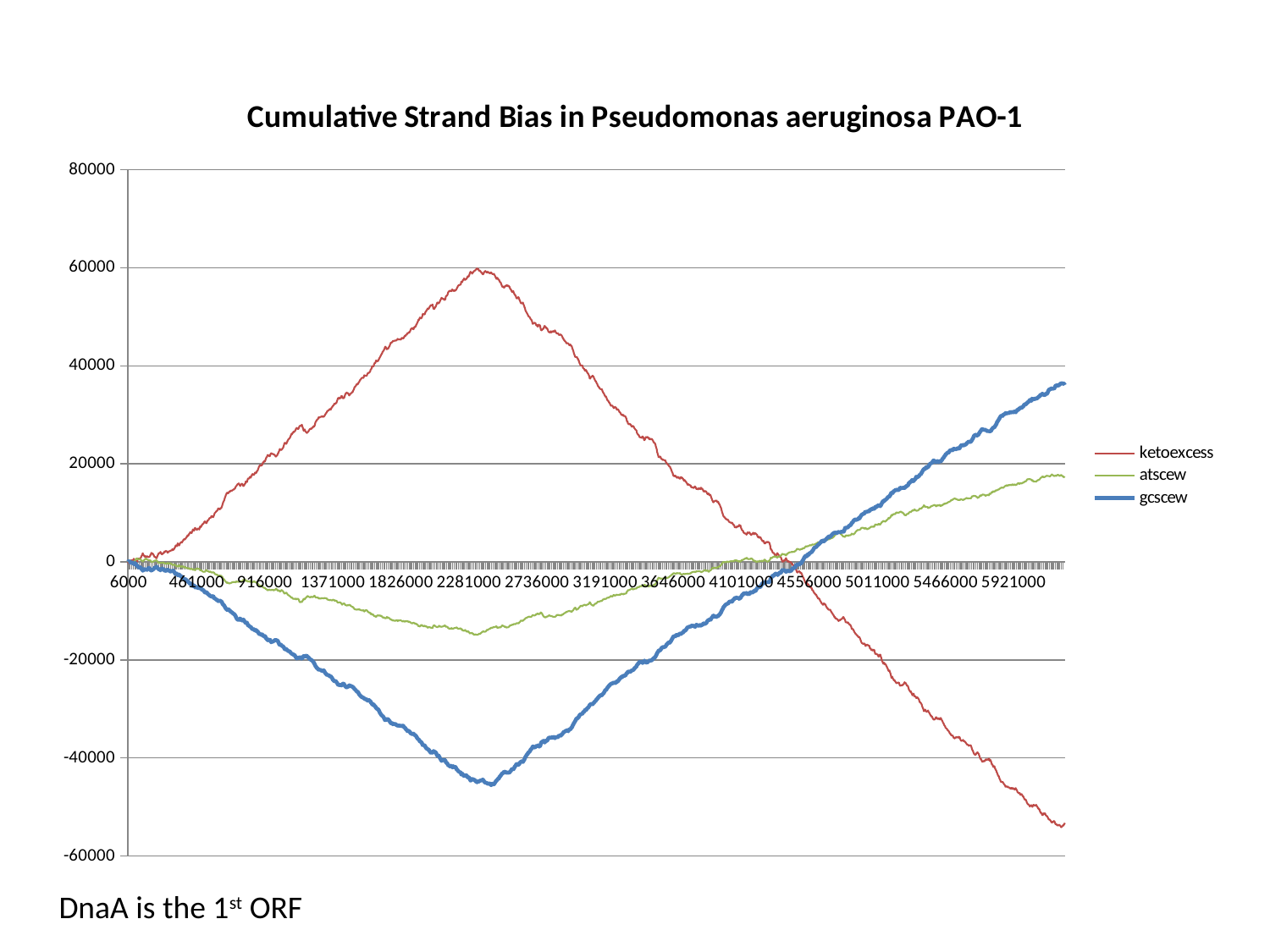
How many series does the legend list? 3 Does the ketoexcess series rise or fall between 2281000 and the right end of the x axis? fall Which series is drawn with the thick blue line? gcscew Which series has the highest value at 2281000? ketoexcess At the right end of the x axis, which series is higher, gcscew or atscew? gcscew Is the value of gcscew at 5921000 greater or less than 20000? greater Is the value of ketoexcess at 2281000 greater or less than 40000? greater Which series has the lowest value at 2281000? gcscew Is the value of gcscew at 2281000 greater or less than -40000? less What is the title of the chart? Cumulative Strand Bias in Pseudomonas aeruginosa PAO-1 What kind of chart is shown on the slide? line chart